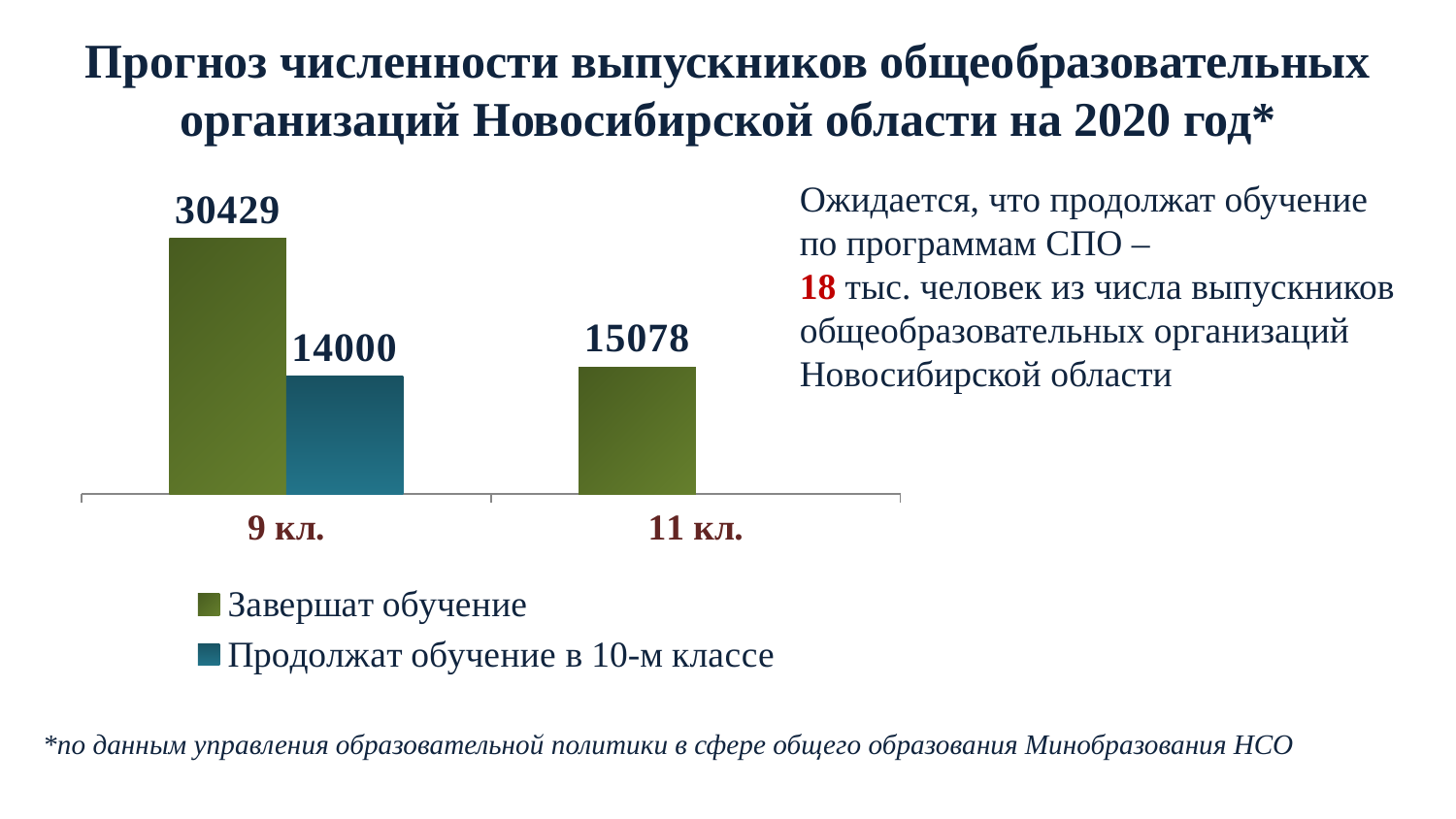
What is the value of "Завершат обучение" for "9 кл."? 30429 What is the value of "Продолжат обучение в 10-м классе" for "9 кл."? 14000 Which category has the highest value for "Завершат обучение"? 9 кл. What kind of chart is shown on the slide? bar chart How many categories are shown on the x axis? 2 Which colour represents the series "Продолжат обучение в 10-м классе"? blue What is the difference between "Завершат обучение" and "Продолжат обучение в 10-м классе" for "9 кл."? 16429 What is the difference between "Завершат обучение" for "9 кл." and for "11 кл."? 15351 What is the value of "Завершат обучение" for "11 кл."? 15078 Which is larger: "Завершат обучение" for "11 кл." or "Продолжат обучение в 10-м классе" for "9 кл."? Завершат обучение for 11 кл. Which category has the lowest value for "Завершат обучение"? 11 кл. How many series does the legend list? 2